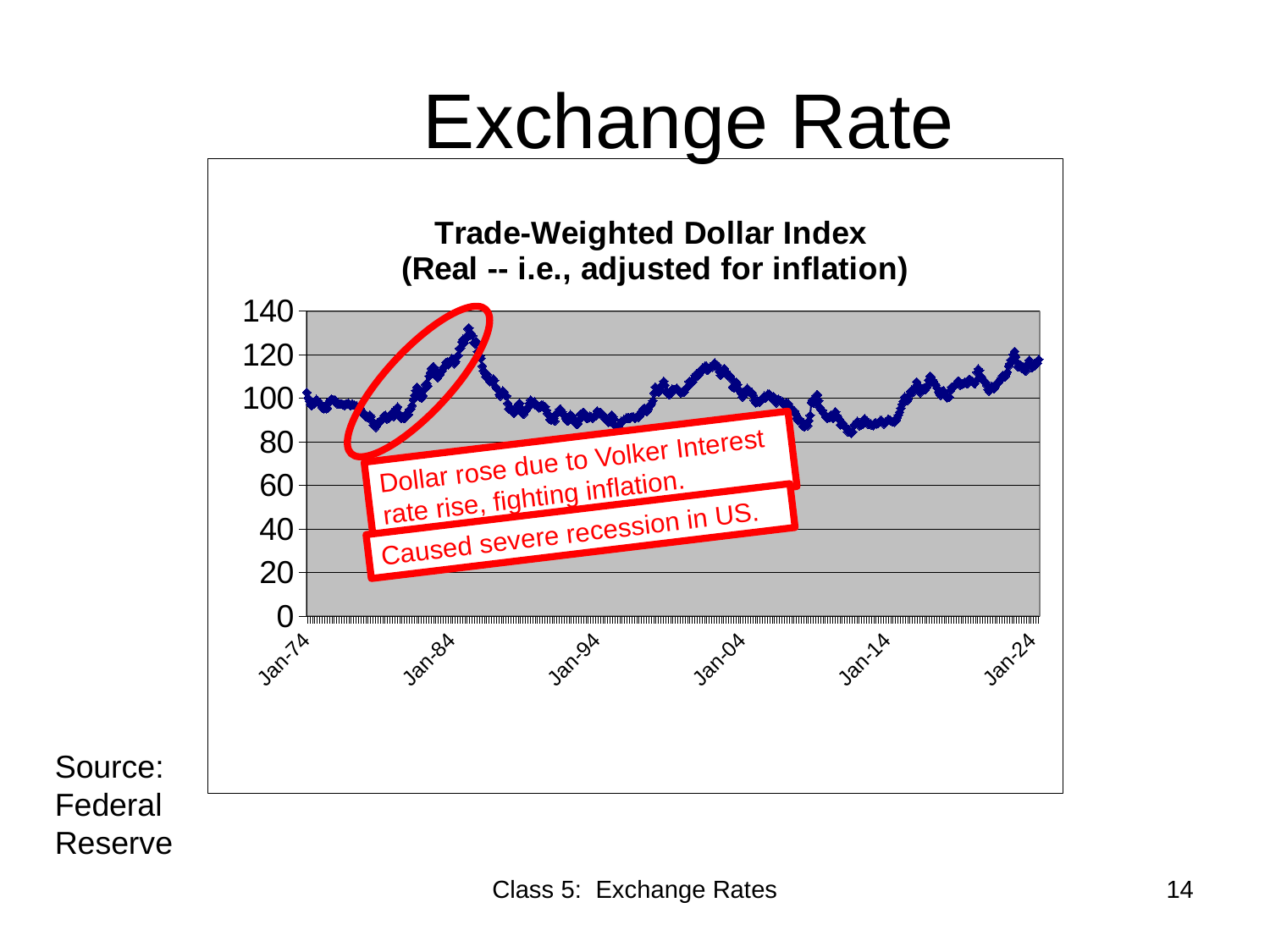
Is the peak value of the Trade-Weighted Dollar Index in the mid-1980s greater or less than 120? greater Does the Trade-Weighted Dollar Index rise or fall between its mid-1980s peak and Jan-94? fall Which is larger, the Trade-Weighted Dollar Index at Jan-04 or at Jan-14? Jan-04 Is the value of the Trade-Weighted Dollar Index at Jan-24 greater or less than 100? greater Is the value of the Trade-Weighted Dollar Index at Jan-94 greater or less than 100? less What is the first date label shown on the horizontal axis of the chart? Jan-74 What is the highest value shown on the vertical axis of the chart? 140 Does the Trade-Weighted Dollar Index rise or fall between Jan-14 and Jan-24? rise What kind of chart is shown on the slide? line chart What is the title of the chart? Trade-Weighted Dollar Index (Real -- i.e., adjusted for inflation)